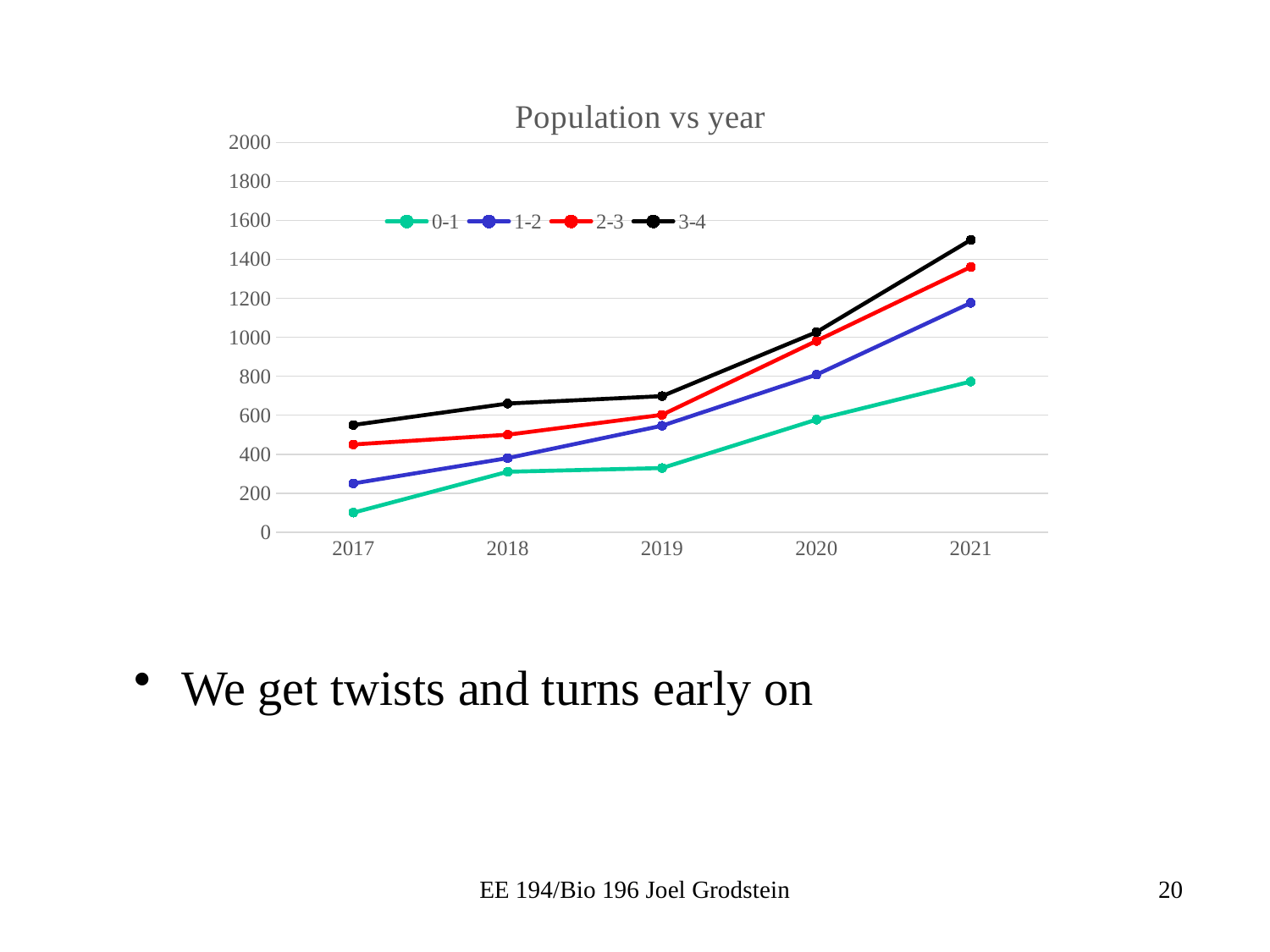
Which series has the lowest value in 2017? 0-1 Which is larger in 2019: the value for the 1-2 series or the value for the 0-1 series? 1-2 What kind of chart is shown on the slide? line chart Which series has the highest value in 2021? 3-4 How many series does the legend list? 4 How many years are shown along the x axis? 5 Which series is drawn in red? 2-3 Is the value for the 3-4 series in 2021 greater or less than 1400? greater What is the title of the chart? Population vs year Is the value for the 0-1 series in 2017 greater or less than 200? less Is the value for the 2-3 series in 2020 greater or less than 800? greater Do the values for the 3-4 series rise or fall from 2017 to 2021? rise